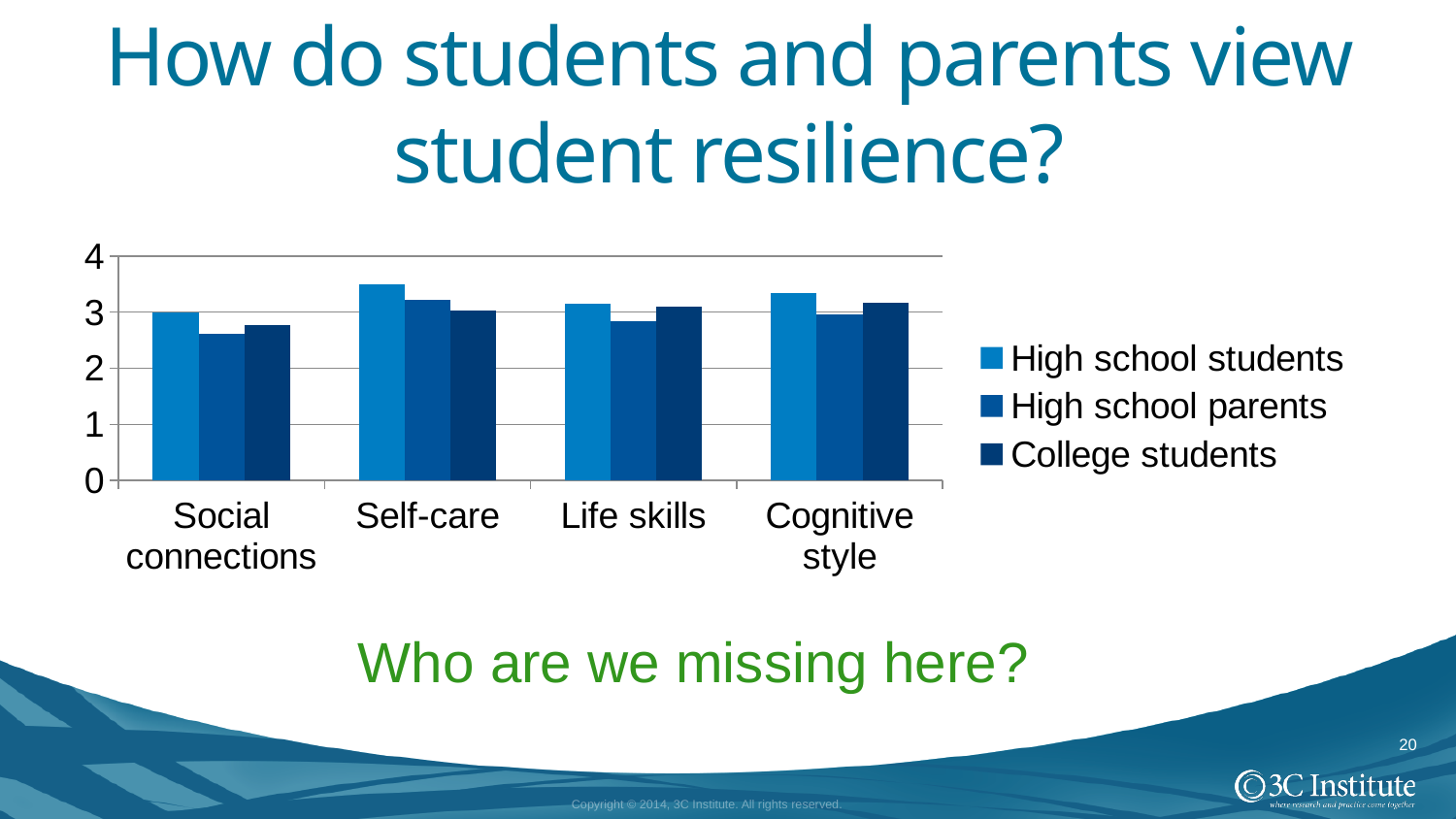
In the Social connections category, which is larger: the value for High school students or for High school parents? High school students Is the value for High school parents in Self-care greater or less than 3? greater Which series is listed last in the chart's legend? College students How many categories are shown on the x axis of the chart? 4 Is the value for High school parents in Social connections greater or less than 3? less How many series does the chart's legend list? 3 What kind of chart is shown on the slide? Bar chart In the Self-care category, which is larger: the value for High school students or for High school parents? High school students In which category is the High school students bar the highest? Self-care Is the value for High school students in Self-care greater or less than 3? greater In which category is the High school parents bar the lowest? Social connections